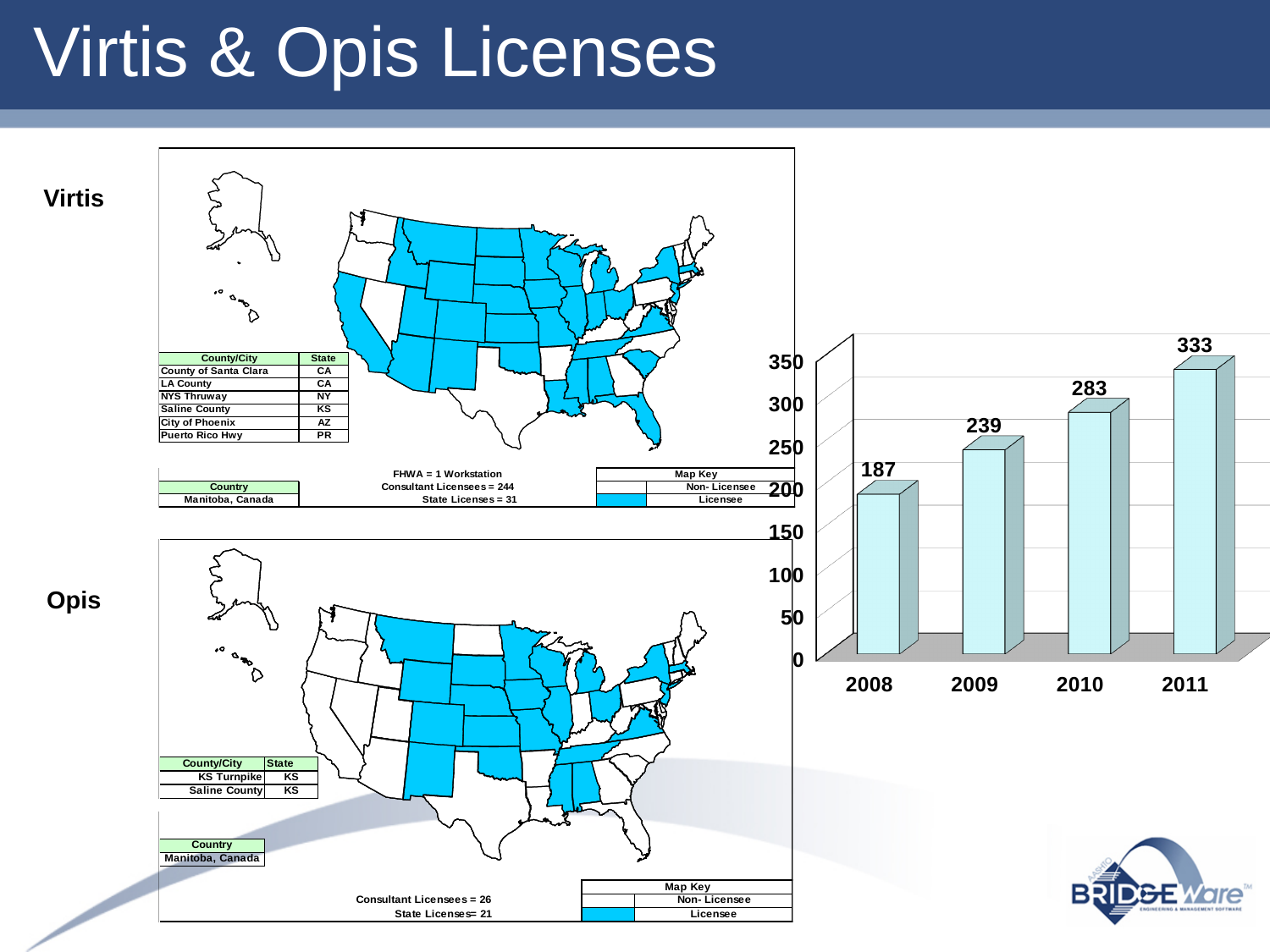
Is the value for 2009 in the bar chart greater or less than 200? greater What value does the bar chart show for 2010? 283 Do the values in the bar chart rise or fall from 2008 to 2011? rise What value does the bar chart show for 2011? 333 How many years are shown on the x axis of the bar chart? 4 What value does the bar chart show for 2008? 187 In the bar chart, which is larger, the value for 2009 or the value for 2010? 2010 What is the difference between the 2011 and 2008 values in the bar chart? 146 Which year has the lowest value in the bar chart? 2008 Which year has the highest value in the bar chart? 2011 What kind of chart is shown on the right side of the slide? bar chart What is the difference between the 2010 and 2009 values in the bar chart? 44